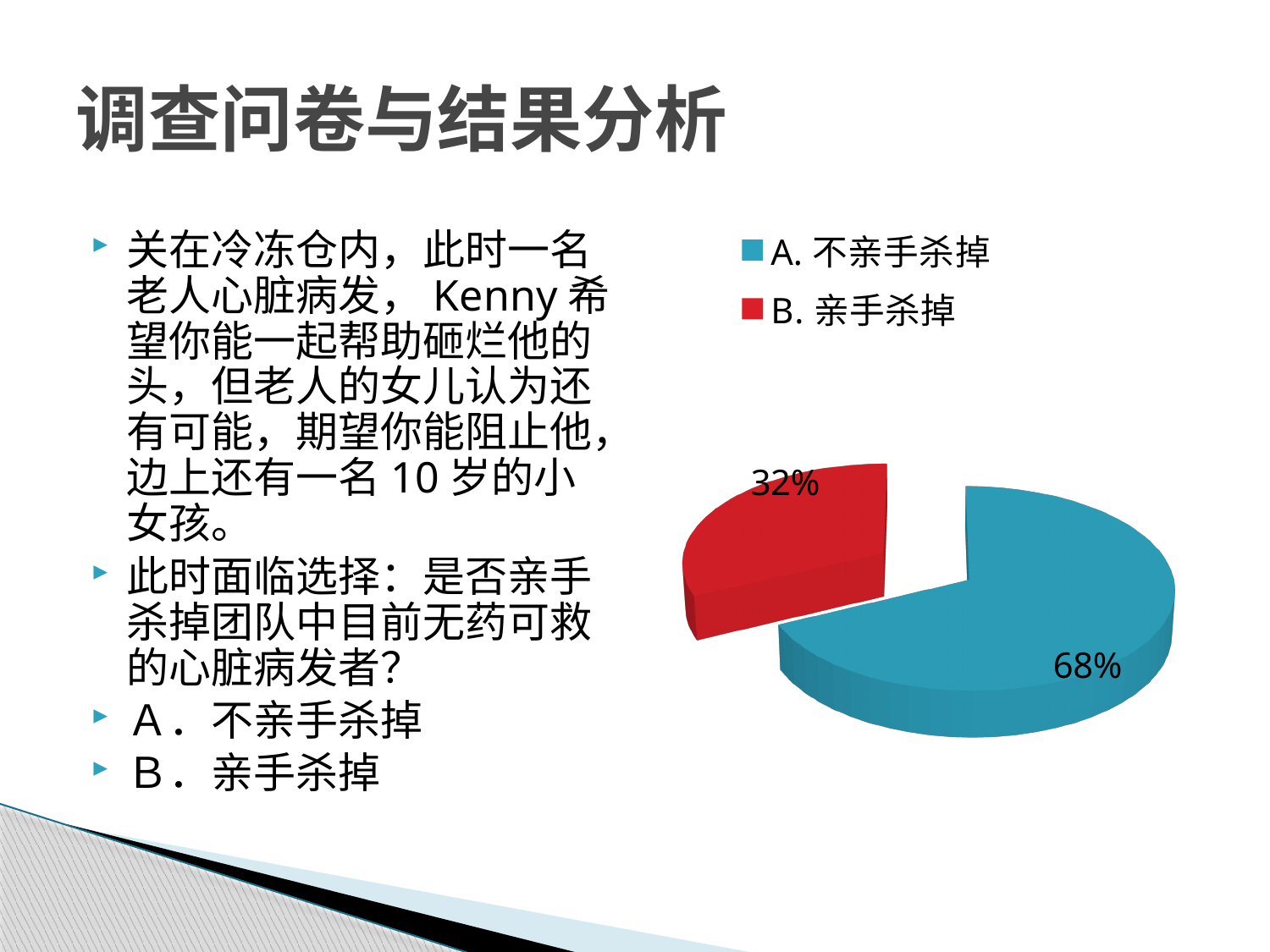
How many entries does the legend list? 2 Which slice of the pie is the largest? A. 不亲手杀掉 What kind of chart is shown on the slide? pie chart Which is larger, the share for "A. 不亲手杀掉" or the share for "B. 亲手杀掉"? A. 不亲手杀掉 Which slice of the pie is the smallest? B. 亲手杀掉 What share of the pie does "A. 不亲手杀掉" take? 68% What colour is the slice for "A. 不亲手杀掉"? blue What colour is the slice for "B. 亲手杀掉"? red What share of the pie does "B. 亲手杀掉" take? 32% How many slices does the pie chart have? 2 What is the difference in percentage points between the "A. 不亲手杀掉" slice and the "B. 亲手杀掉" slice? 36